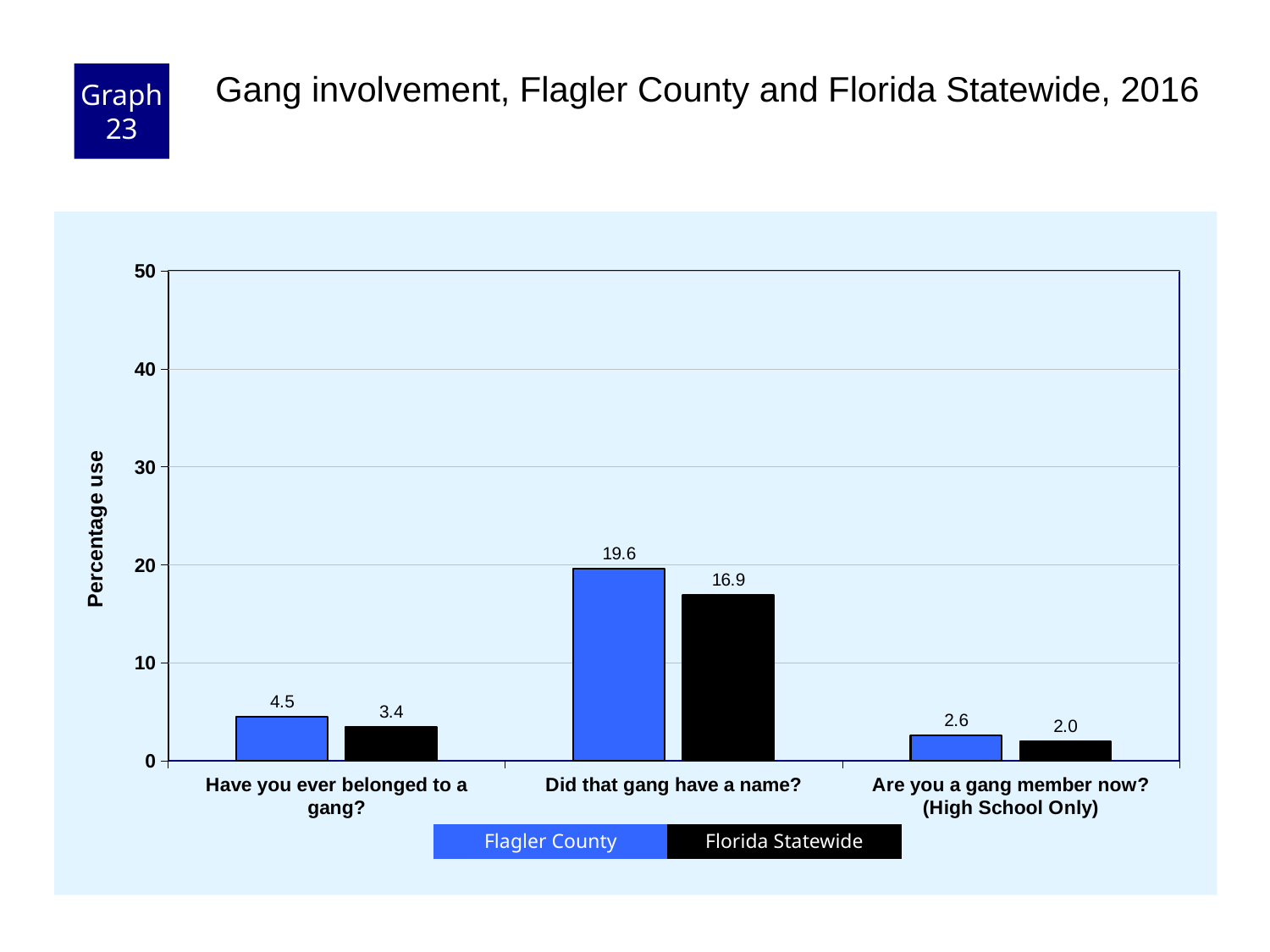
Which question has the highest Flagler County value? Did that gang have a name? Which question has the lowest Florida Statewide value? Are you a gang member now? (High School Only) What is the Florida Statewide value for "Did that gang have a name?"? 16.9 Is the Flagler County value for "Did that gang have a name?" greater or less than 10? greater How many series does the legend list? 2 What is the label of the y axis? Percentage use For "Have you ever belonged to a gang?", which is larger: Flagler County or Florida Statewide? Flagler County What is the Florida Statewide value for "Are you a gang member now? (High School Only)"? 2.0 How many questions (categories) are shown on the x axis? 3 What is the Flagler County value for "Have you ever belonged to a gang?"? 4.5 What kind of chart is shown on the slide? Bar chart What is the difference between the Flagler County and Florida Statewide values for "Did that gang have a name?"? 2.7